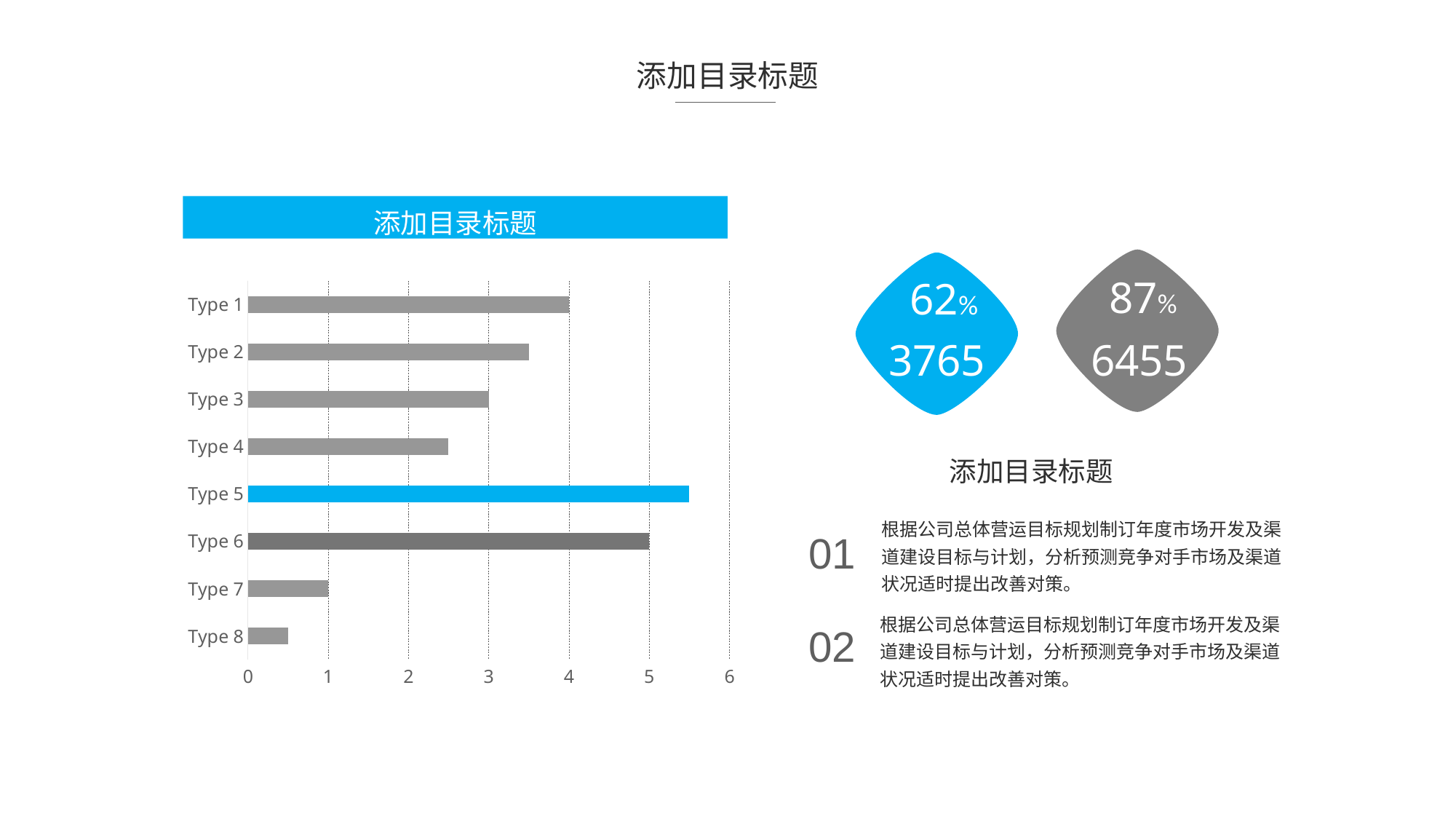
Which bar in the chart is coloured blue rather than grey? Type 5 What kind of chart is shown on the slide? bar chart What is the value for Type 1? 4 What is the value for Type 6? 5 What is the difference between the values for Type 1 and Type 3? 1 Which category has the lowest value in the bar chart? Type 8 Is the value for Type 2 greater or less than 3? greater Do the values rise or fall from Type 1 to Type 4? fall What is the value for Type 7? 1 Which category has the highest value in the bar chart? Type 5 How many categories are plotted in the bar chart? 8 Which is larger, the value for Type 5 or the value for Type 6? Type 5